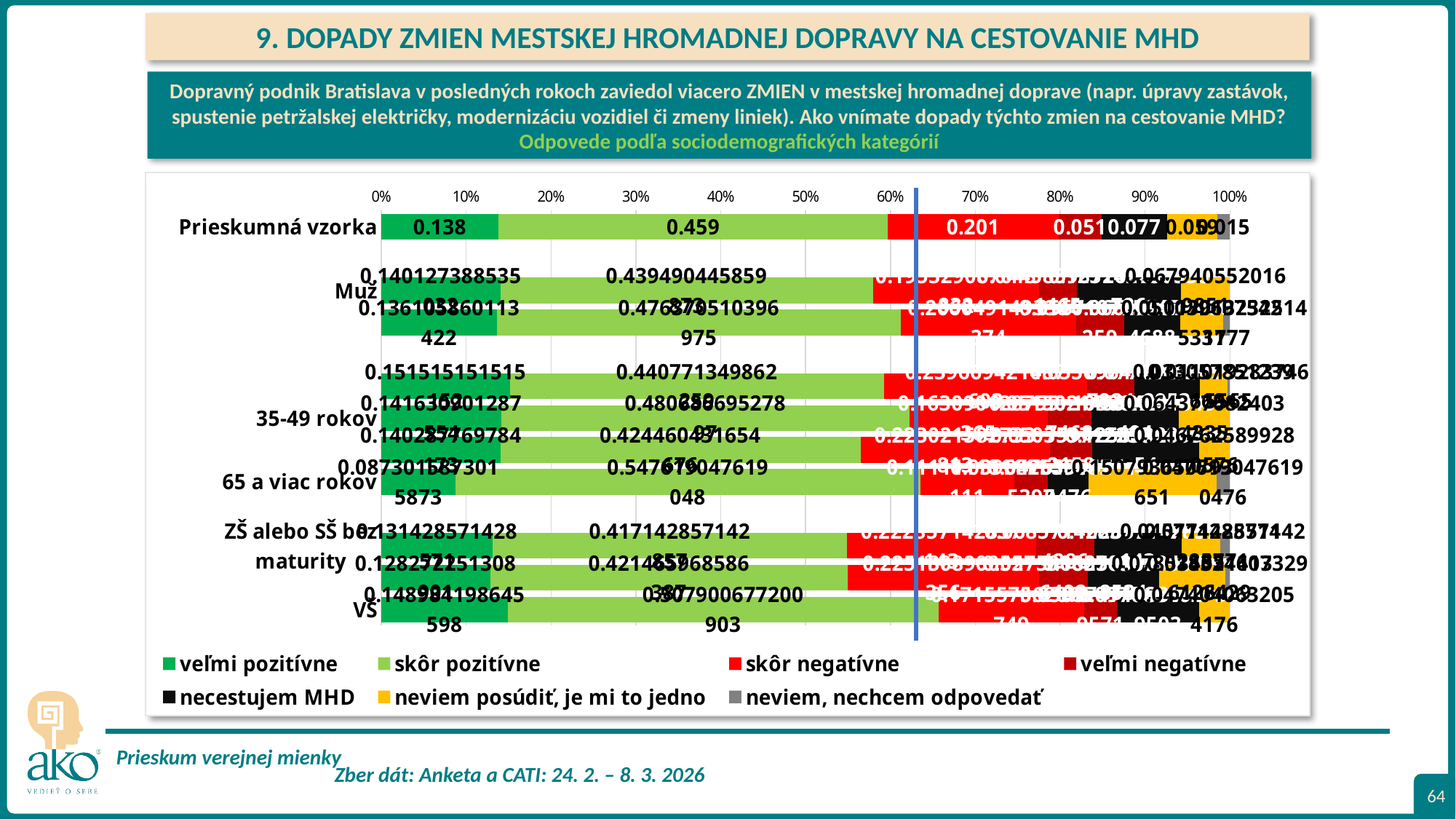
What is the value of 'veľmi pozitívne' for Prieskumná vzorka? 0.138 What is the value of 'skôr negatívne' for Prieskumná vzorka? 0.201 What is the total of all segments in the Prieskumná vzorka bar? 1.000 What colour represents 'skôr negatívne' in the chart legend? Red What kind of chart is shown on the slide? Stacked horizontal bar chart What is the value of 'necestujem MHD' for Prieskumná vzorka? 0.077 How many series does the chart legend list? 7 What is the value of 'skôr pozitívne' for Prieskumná vzorka? 0.459 Which response category has the smallest share in the Prieskumná vzorka bar? neviem, nechcem odpovedať What is the difference between 'skôr pozitívne' and 'veľmi pozitívne' for Prieskumná vzorka? 0.321 For Prieskumná vzorka, which is larger: 'veľmi pozitívne' or 'skôr negatívne'? skôr negatívne Which response category has the largest share in the Prieskumná vzorka bar? skôr pozitívne